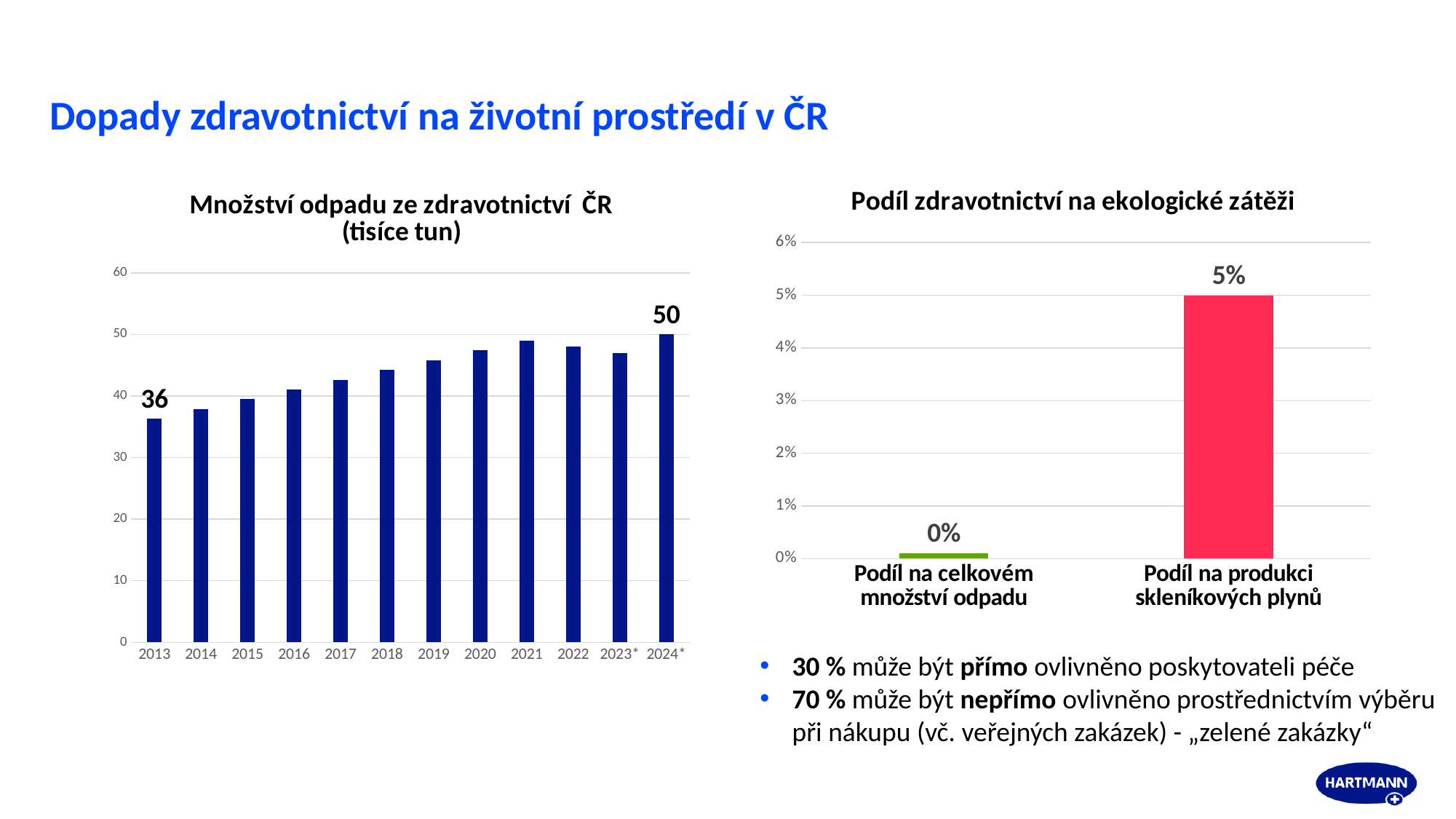
In the chart 'Množství odpadu ze zdravotnictví ČR (tisíce tun)', what is the value for 2024*? 50 How many years are shown on the x axis of the chart 'Množství odpadu ze zdravotnictví ČR (tisíce tun)'? 12 In the chart 'Množství odpadu ze zdravotnictví ČR (tisíce tun)', which year has the highest value? 2024* In the chart 'Množství odpadu ze zdravotnictví ČR (tisíce tun)', do the values generally rise or fall from 2013 to 2024*? rise In the chart 'Množství odpadu ze zdravotnictví ČR (tisíce tun)', is the value for 2020 greater or less than 50? less What kind of chart is 'Podíl zdravotnictví na ekologické zátěži'? bar chart In the chart 'Množství odpadu ze zdravotnictví ČR (tisíce tun)', which year has the lowest value? 2013 In the chart 'Množství odpadu ze zdravotnictví ČR (tisíce tun)', what is the difference between the values for 2024* and 2013? 14 In the chart 'Množství odpadu ze zdravotnictví ČR (tisíce tun)', is the value for 2018 greater or less than 40? greater In the chart 'Množství odpadu ze zdravotnictví ČR (tisíce tun)', what is the value for 2013? 36 In the chart 'Podíl zdravotnictví na ekologické zátěži', what is the value for 'Podíl na produkci skleníkových plynů'? 5% In the chart 'Podíl zdravotnictví na ekologické zátěži', what is the value for 'Podíl na celkovém množství odpadu'? 0%